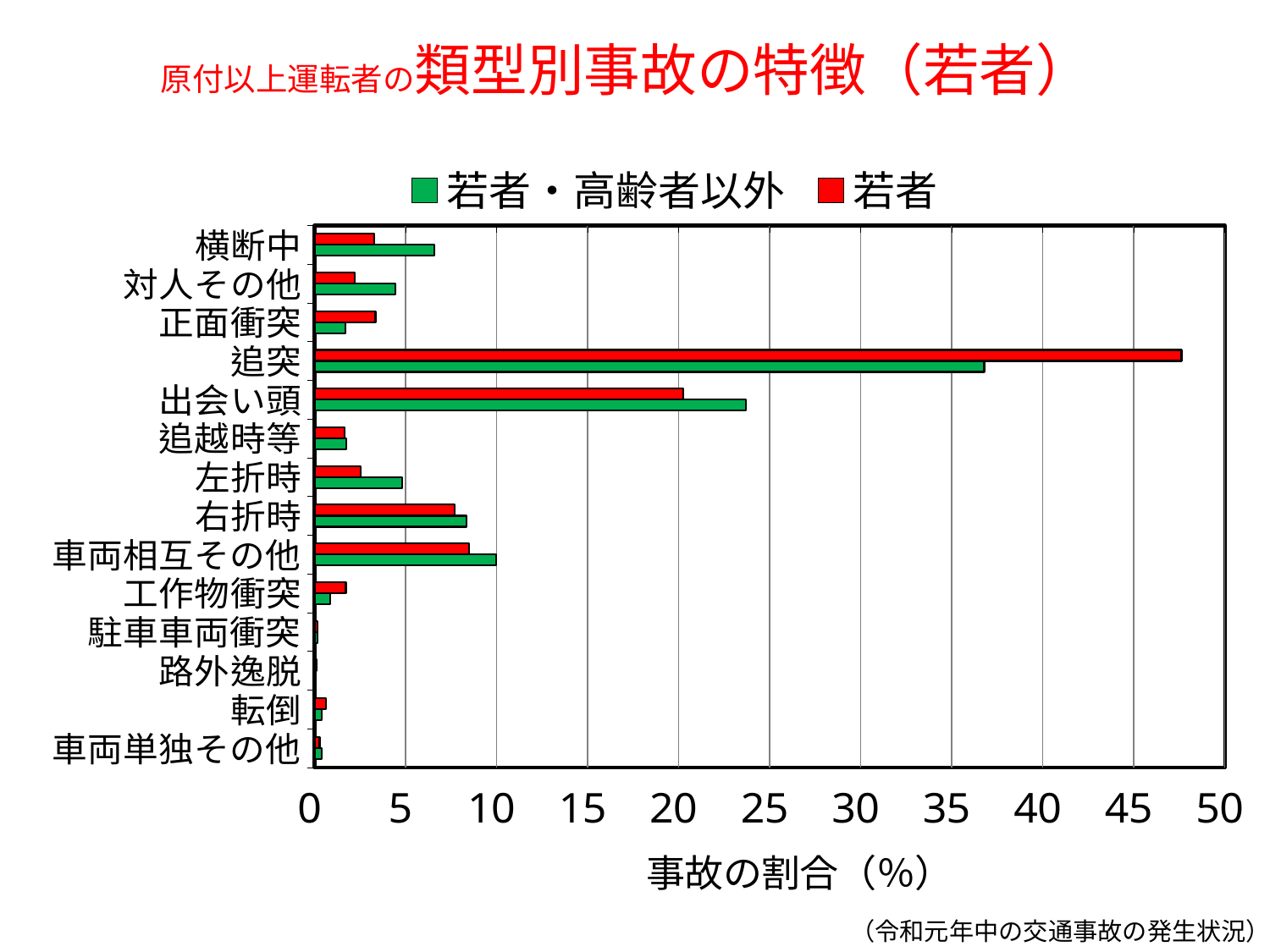
Which category has the highest value for the 若者 series? 追突 Is the 若者・高齢者以外 value for 追突 greater or less than 40? less Is the 若者 value for 出会い頭 greater or less than 25? less For 出会い頭, which series has the larger value, 若者 or 若者・高齢者以外? 若者・高齢者以外 How many accident-type categories are plotted on the y axis? 14 How many series does the legend list? 2 Is the 若者 value for 追突 greater or less than 45? greater For 追突, which series has the larger value, 若者 or 若者・高齢者以外? 若者 For 横断中, which series has the larger value, 若者 or 若者・高齢者以外? 若者・高齢者以外 What kind of chart is shown on the slide? bar chart Which category has the highest value for the 若者・高齢者以外 series? 追突 What is the label of the x axis? 事故の割合（%）